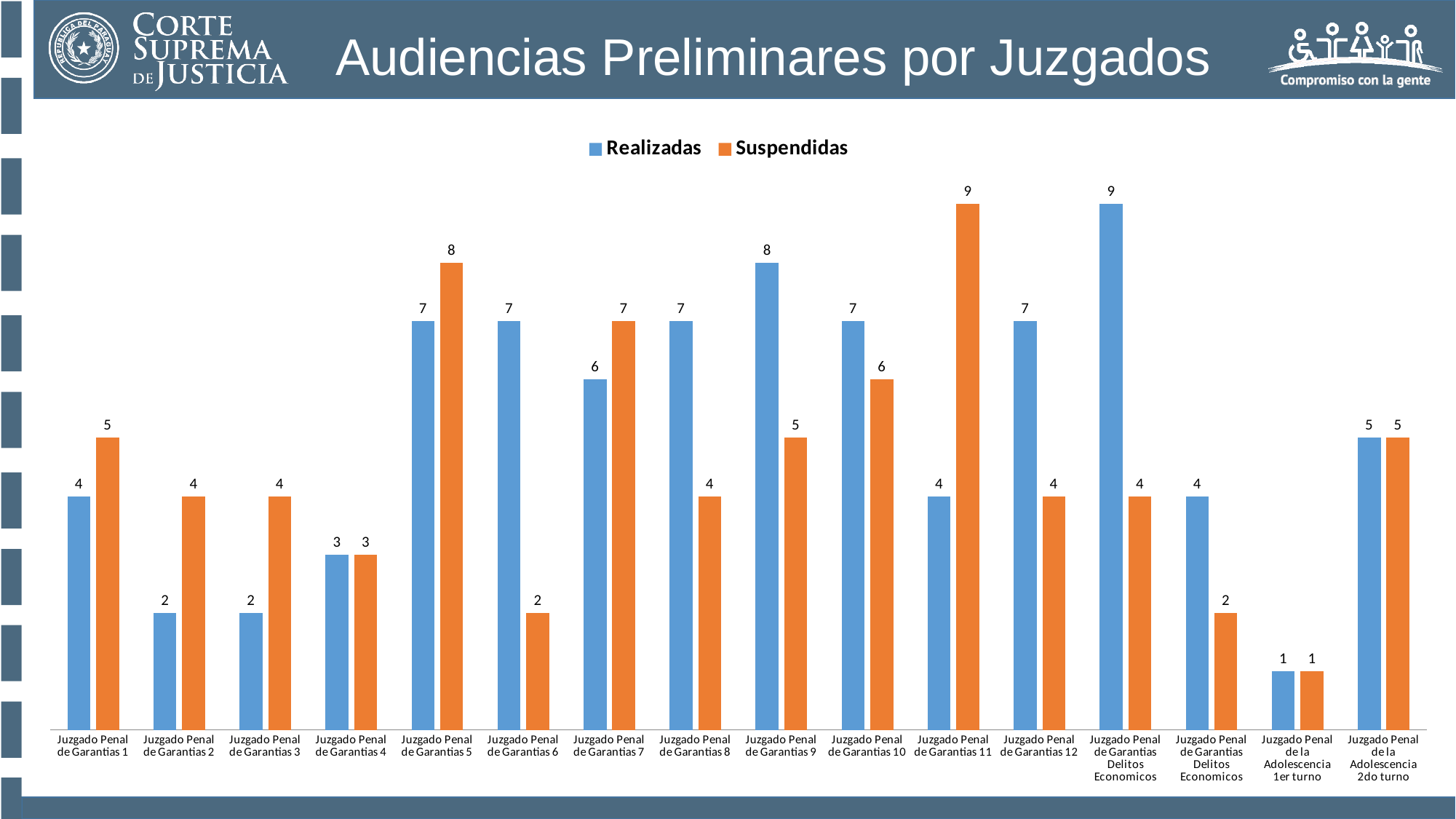
Which juzgado has the highest Suspendidas value? Juzgado Penal de Garantias 11 How many series does the legend list? 2 What kind of chart is shown on the slide? Bar chart What is the Suspendidas value for Juzgado Penal de la Adolescencia 2do turno? 5 What is the difference between the Suspendidas values for Juzgado Penal de Garantias 11 and Juzgado Penal de Garantias 2? 5 What is the difference between Realizadas and Suspendidas for Juzgado Penal de Garantias 6? 5 What is the Suspendidas value for Juzgado Penal de Garantias 11? 9 For Juzgado Penal de Garantias 8, which is larger, Realizadas or Suspendidas? Realizadas How many juzgados (categories) are shown on the x axis? 16 Which juzgado has the lowest Realizadas value? Juzgado Penal de la Adolescencia 1er turno What is the Realizadas value for Juzgado Penal de Garantias 6? 7 What is the Realizadas value for Juzgado Penal de Garantias 9? 8